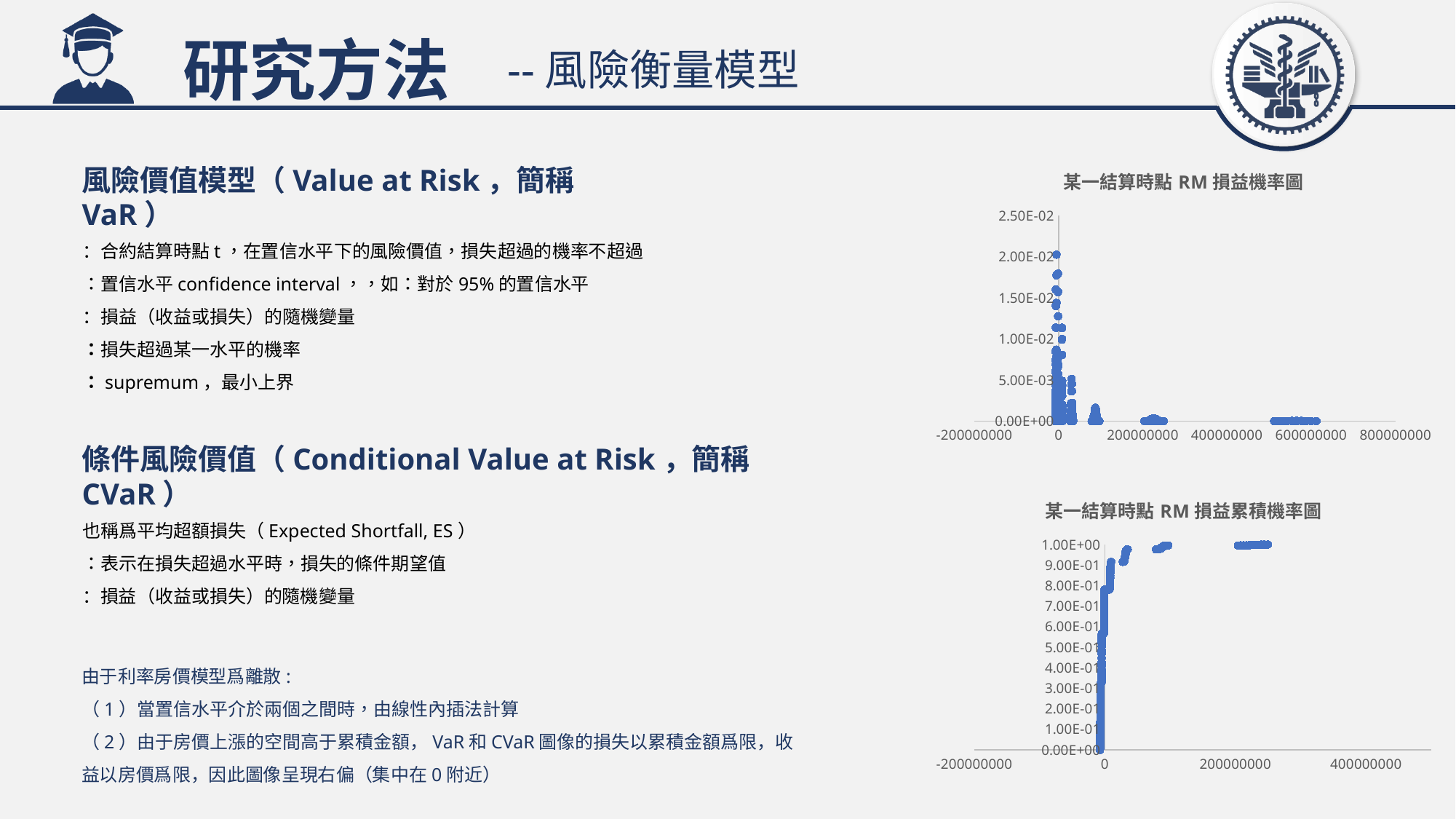
What is the title of the bottom chart on the slide? 某一結算時點 RM 損益累積機率圖 What kind of chart is the bottom chart titled 某一結算時點 RM 損益累積機率圖? scatter chart In the bottom chart 某一結算時點 RM 損益累積機率圖, what is the highest value shown on the y axis? 1.00E+00 In the bottom chart 某一結算時點 RM 損益累積機率圖, do the plotted values rise or fall as the x-axis value increases? rise What is the title of the top chart on the slide? 某一結算時點 RM 損益機率圖 In the bottom chart 某一結算時點 RM 損益累積機率圖, are the points near x = 200000000 greater or less than 9.00E-01 on the y axis? greater In the top chart 某一結算時點 RM 損益機率圖, are the points near x = 600000000 greater or less than 5.00E-03 on the y axis? less What kind of chart is the top chart titled 某一結算時點 RM 損益機率圖? scatter chart